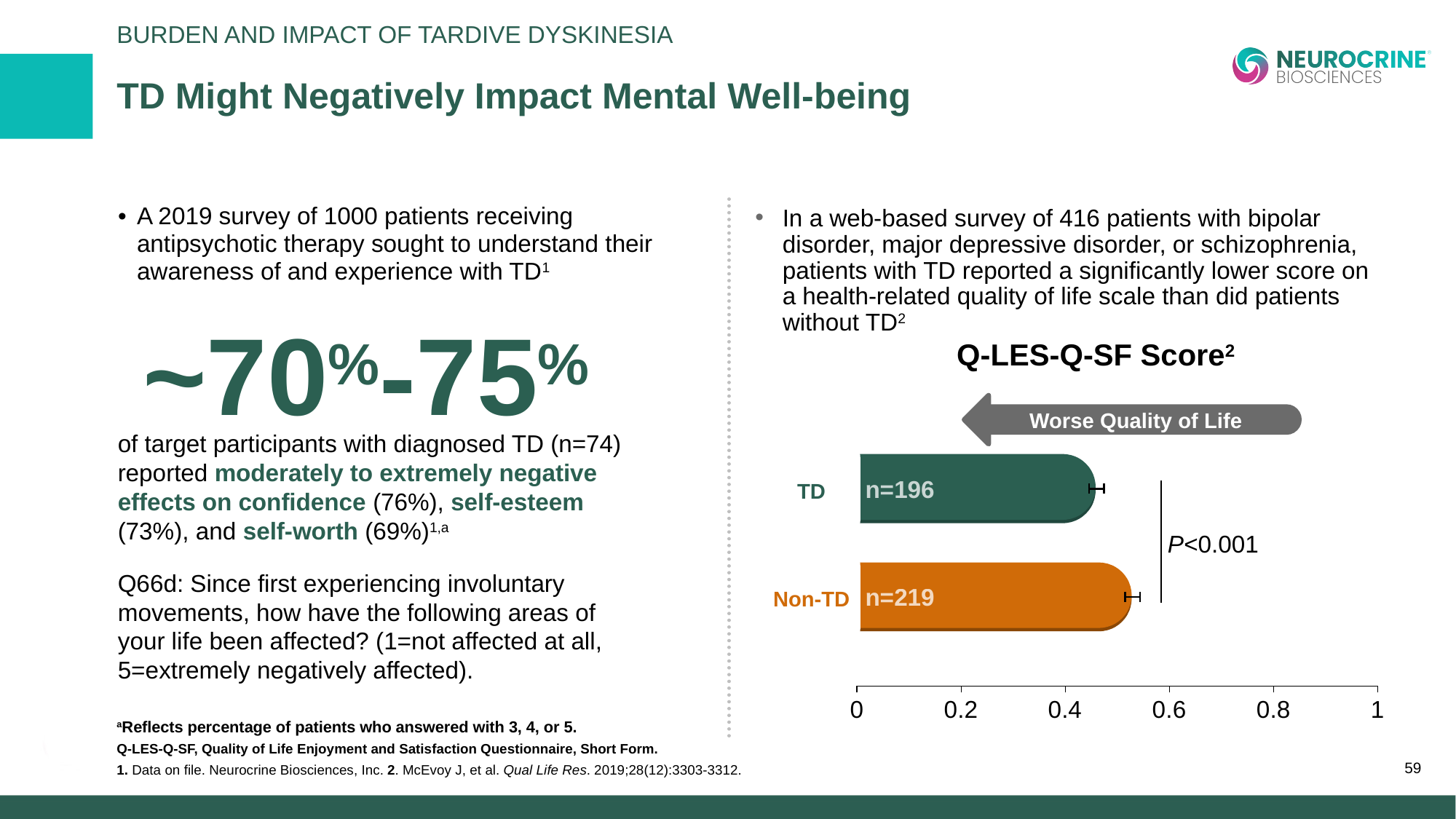
In the Q-LES-Q-SF Score chart, which group has the lowest score? TD In the Q-LES-Q-SF Score chart, is the value for Non-TD greater or less than 0.4? greater In the Q-LES-Q-SF Score chart, is the value for TD greater or less than 0.4? greater What does the grey arrow above the bars in the Q-LES-Q-SF Score chart say? Worse Quality of Life In the Q-LES-Q-SF Score chart, is the value for TD greater or less than 0.6? less In the Q-LES-Q-SF Score chart, what sample size is printed on the Non-TD bar? n=219 In the Q-LES-Q-SF Score chart, which group has the longer bar, TD or Non-TD? Non-TD In the Q-LES-Q-SF Score chart, what sample size is printed on the TD bar? n=196 What p-value is annotated between the two bars in the Q-LES-Q-SF Score chart? P<0.001 What kind of chart is shown under the title "Q-LES-Q-SF Score"? bar chart How many categories (bars) does the Q-LES-Q-SF Score chart show? 2